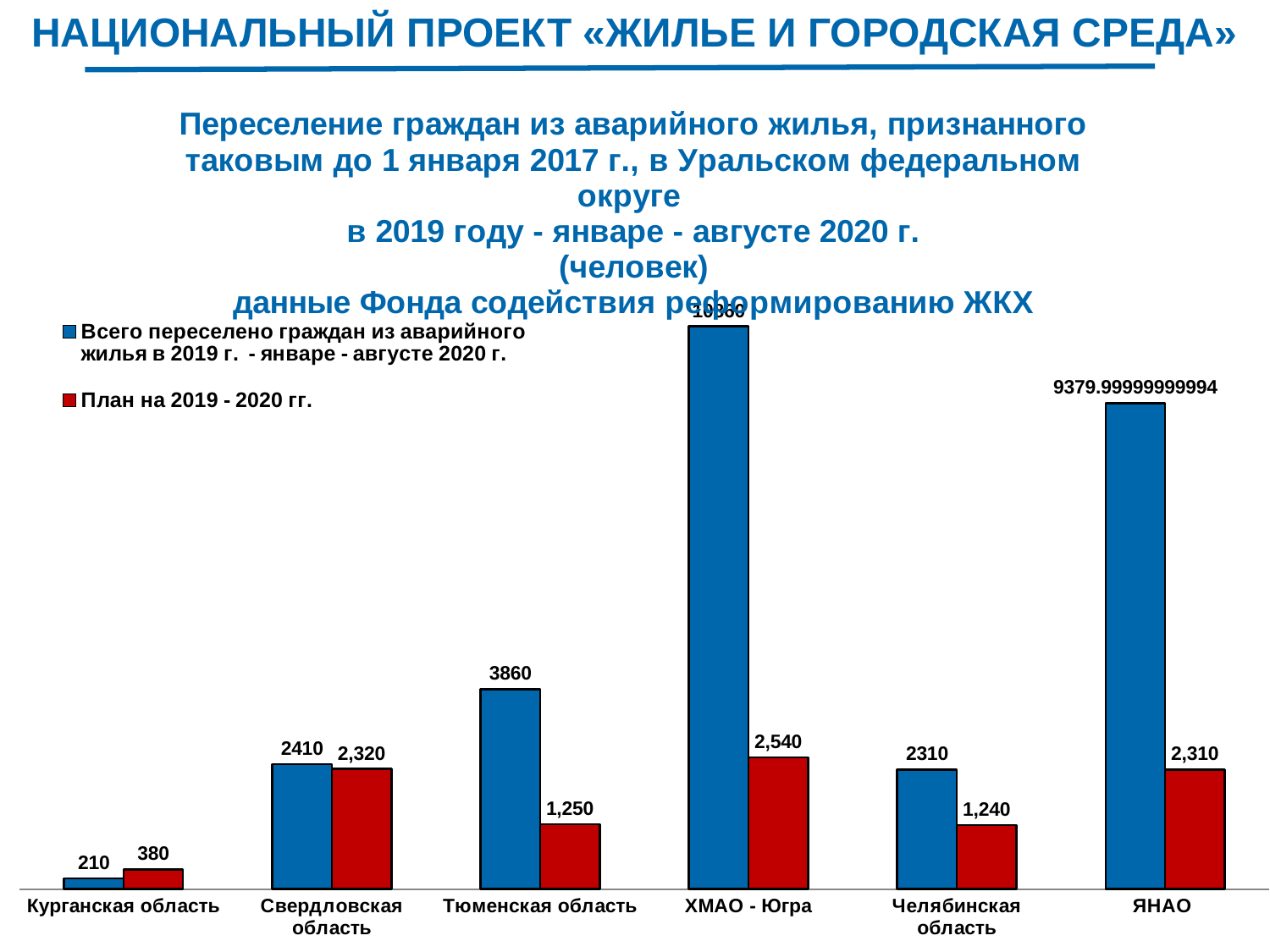
What is the difference between the 'Всего переселено' value and the 'План на 2019 - 2020 гг.' value for Тюменская область? 2610 How many series does the chart legend list? 2 What colour are the bars for the series 'План на 2019 - 2020 гг.'? red What is the value of 'Всего переселено граждан из аварийного жилья в 2019 г. - январе - августе 2020 г.' for Тюменская область? 3860 What is the value of 'План на 2019 - 2020 гг.' for Челябинская область? 1,240 Which region has the lowest value for 'План на 2019 - 2020 гг.'? Курганская область What is the value of 'План на 2019 - 2020 гг.' for Курганская область? 380 For Курганская область, which is larger: the 'Всего переселено' value or the 'План на 2019 - 2020 гг.' value? План на 2019 - 2020 гг. Which region has the highest value for 'Всего переселено граждан из аварийного жилья в 2019 г. - январе - августе 2020 г.'? ХМАО - Югра What is the value of 'Всего переселено граждан из аварийного жилья в 2019 г. - январе - августе 2020 г.' for ЯНАО? 9379.99999999994 How many regions are shown on the x axis of the chart? 6 What type of chart is shown on the slide? bar chart